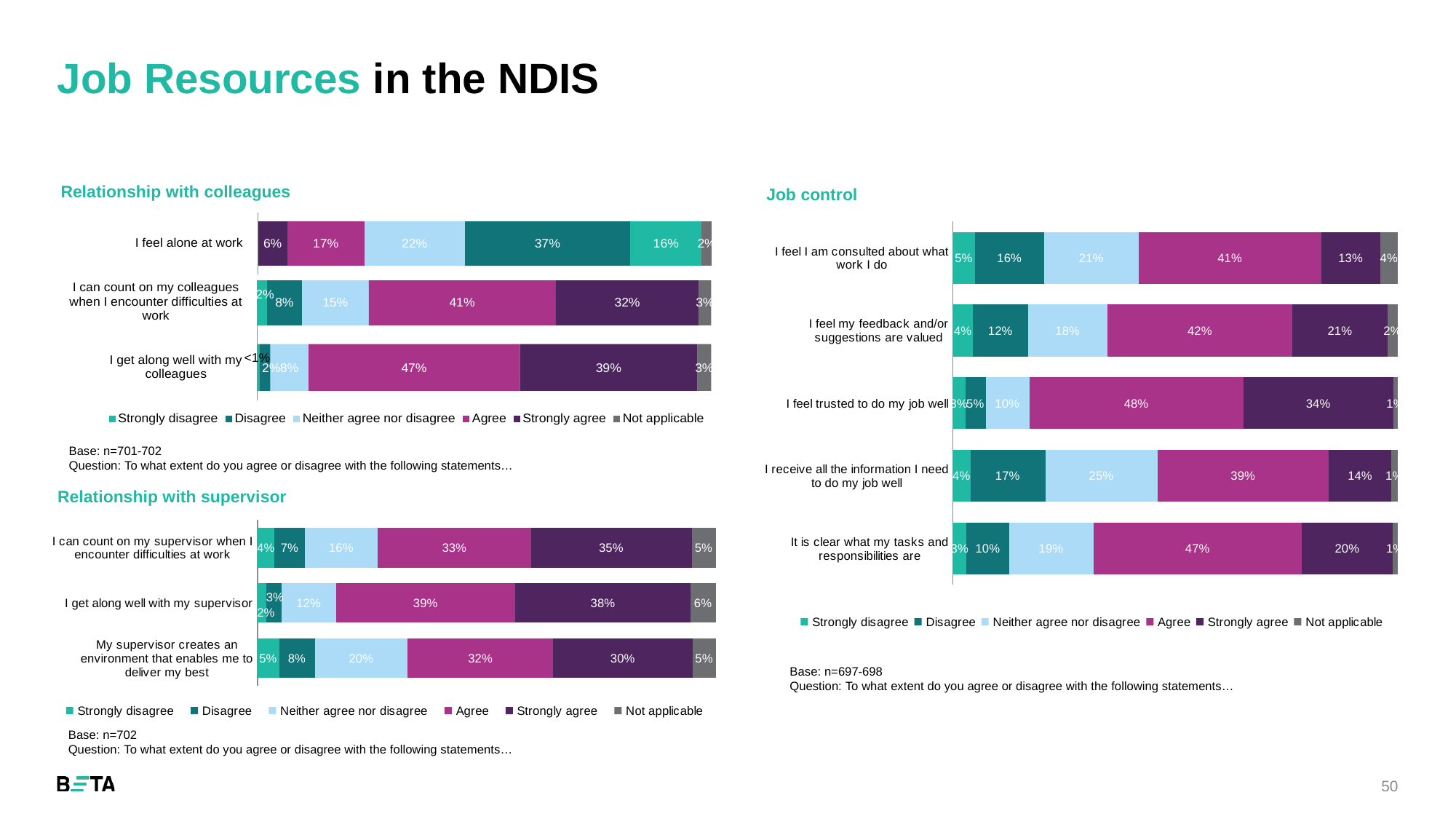
How many response categories does the legend of the Relationship with supervisor chart list? 6 In the Relationship with supervisor chart, how many percentage points higher is the 'Agree' share for 'I get along well with my supervisor' than for 'My supervisor creates an environment that enables me to deliver my best'? 7 percentage points In the Job control chart, which statement has the highest 'Agree' percentage? I feel trusted to do my job well In the Job control chart, what percentage of respondents 'Agree' with 'I feel trusted to do my job well'? 48% In the Relationship with supervisor chart, what percentage 'Strongly agree' with 'I get along well with my supervisor'? 38% In the Relationship with supervisor chart, what is the combined 'Agree' and 'Strongly agree' percentage for 'I can count on my supervisor when I encounter difficulties at work'? 68% In the Relationship with colleagues chart, what percentage 'Agree' with 'I can count on my colleagues when I encounter difficulties at work'? 41% In the Relationship with supervisor chart, what is the 'Not applicable' percentage for 'I get along well with my supervisor'? 6% What type of chart is the Relationship with colleagues chart? Stacked bar chart In the Job control chart, which statement has the lowest 'Strongly agree' percentage? I feel I am consulted about what work I do How many statements are shown in the Job control chart? 5 In the Job control chart, which has the larger 'Neither agree nor disagree' share: 'I receive all the information I need to do my job well' or 'I feel my feedback and/or suggestions are valued'? I receive all the information I need to do my job well